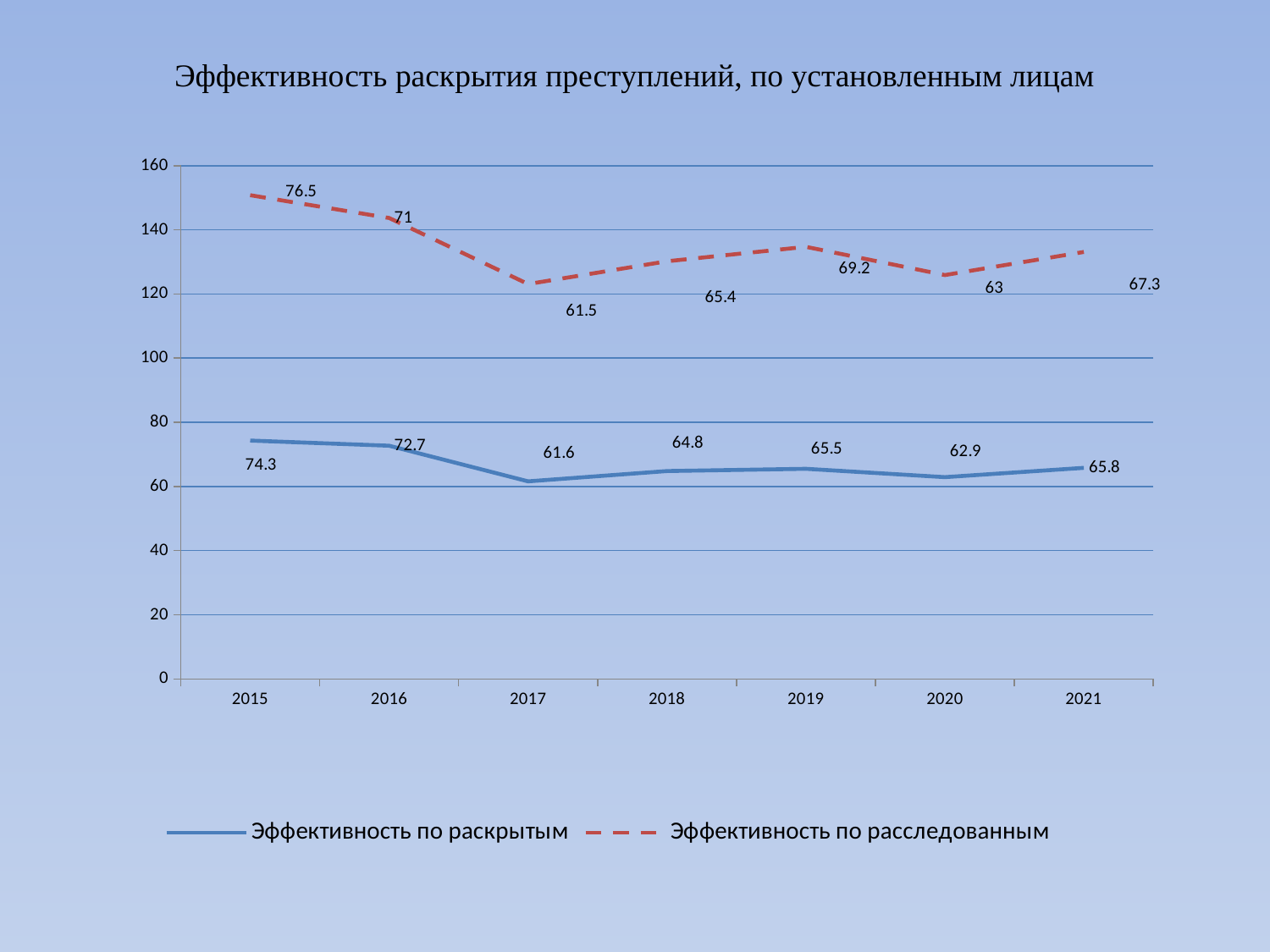
Does Эффективность по раскрытым rise or fall from 2015 to 2017? Fall What is the title of the chart? Эффективность раскрытия преступлений, по установленным лицам What is the value for Эффективность по раскрытым in 2015? 74.3 In which year is Эффективность по раскрытым lowest? 2017 In which year is Эффективность по расследованным highest? 2015 What is the difference between Эффективность по расследованным and Эффективность по раскрытым in 2015? 2.2 How many series does the legend list? 2 What is the value for Эффективность по расследованным in 2019? 69.2 What kind of chart is shown on the slide? Line chart Which series has the larger value in 2019, Эффективность по раскрытым or Эффективность по расследованным? Эффективность по расследованным What is the value for Эффективность по расследованным in 2021? 67.3 How many years are shown on the x axis? 7